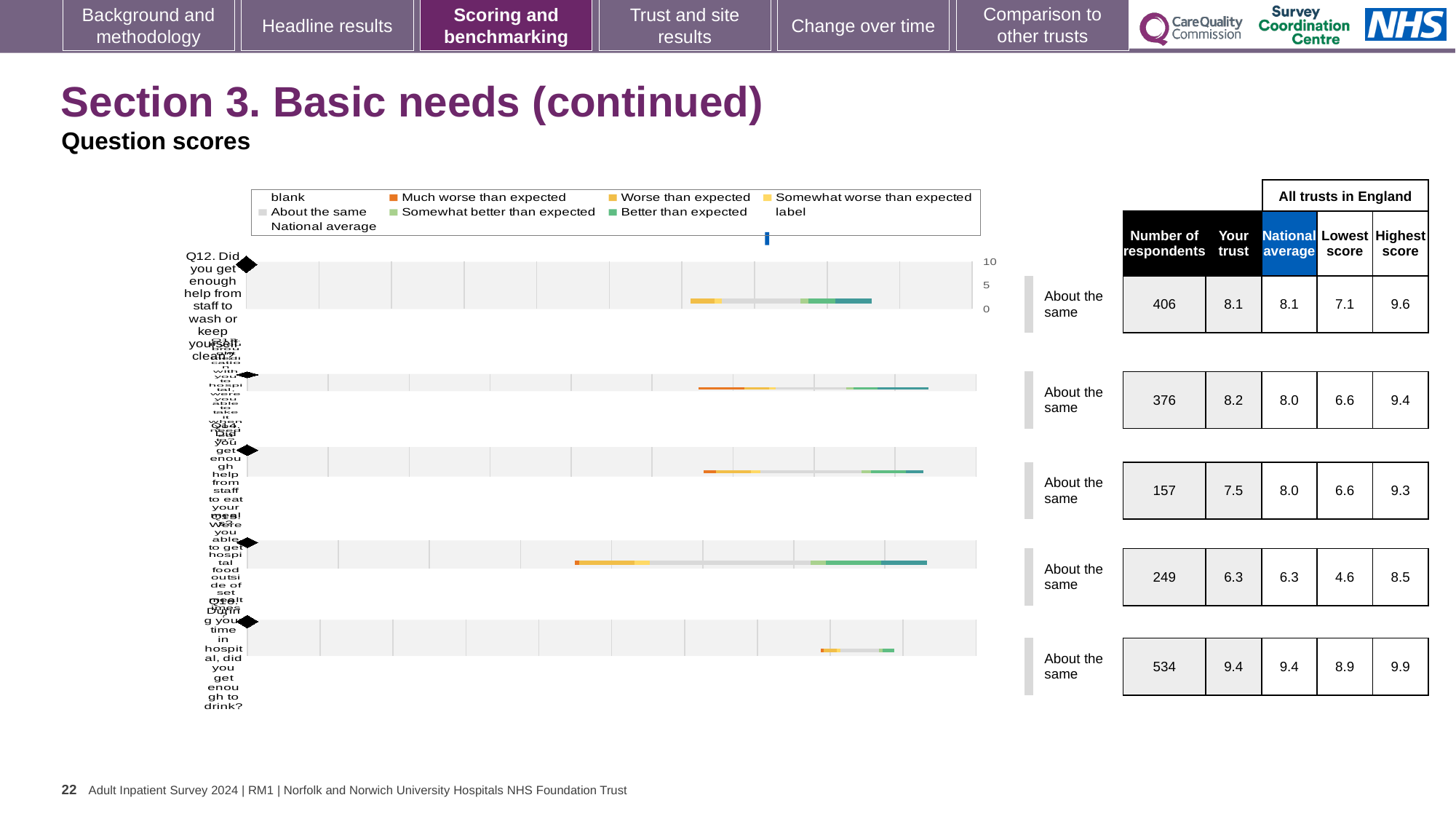
How many question bars are plotted in the chart? 5 Which row in the table has the highest 'Your trust' score? the last row (Q16), 9.4 In the table beside the chart, what is the 'Lowest score' for the fourth row (the row with 249 respondents)? 4.6 What benchmark category is shown next to every bar in the chart? About the same In the table beside the chart, what is the 'Your trust' score for the first row (Q12)? 8.1 In the third row of the table (157 respondents), which is larger: the 'Your trust' score or the 'National average'? National average (8.0) Which row in the table has the lowest 'Your trust' score? the fourth row (Q15), 6.3 In the table beside the chart, how many respondents are listed for the first row (Q12, help from staff to wash or keep yourself clean)? 406 For the first row (Q12), what is the difference between the highest score (9.6) and the lowest score (7.1)? 2.5 What kind of chart is shown on the slide? bar chart In the table beside the chart, what is the 'Highest score' for the last row (Q16, enough to drink)? 9.9 In the second row of the table (376 respondents), which is larger: the 'Your trust' score or the 'National average'? Your trust (8.2)